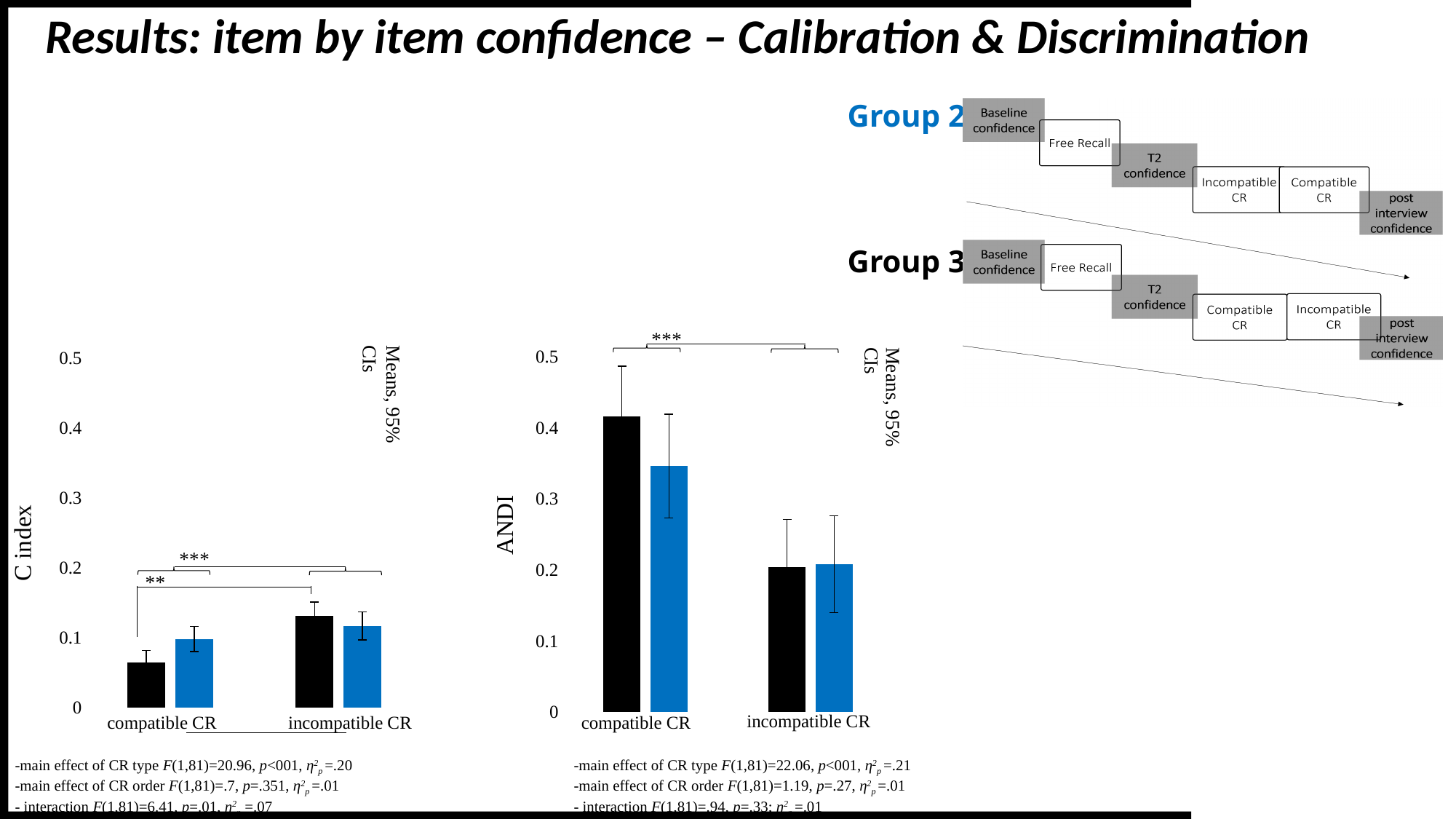
In the right chart labelled ANDI, is the black bar for incompatible CR greater or less than 0.3? less What is the y-axis label of the right chart? ANDI In the left chart labelled C index, is the black bar for compatible CR greater or less than 0.1? less In the left chart labelled C index, for compatible CR, which bar is taller: the black bar or the blue bar? the blue bar In the right chart labelled ANDI, which is larger: the black bar for compatible CR or the black bar for incompatible CR? compatible CR In the right chart labelled ANDI, do the bar values rise or fall from compatible CR to incompatible CR? fall What kind of chart is the left chart labelled C index? bar chart In the left chart labelled C index, which is larger: the black bar for compatible CR or the black bar for incompatible CR? incompatible CR In the right chart labelled ANDI, is the blue bar for compatible CR greater or less than 0.4? less How many categories are shown on the x axis of the right chart labelled ANDI? 2 What is the y-axis label of the left chart? C index